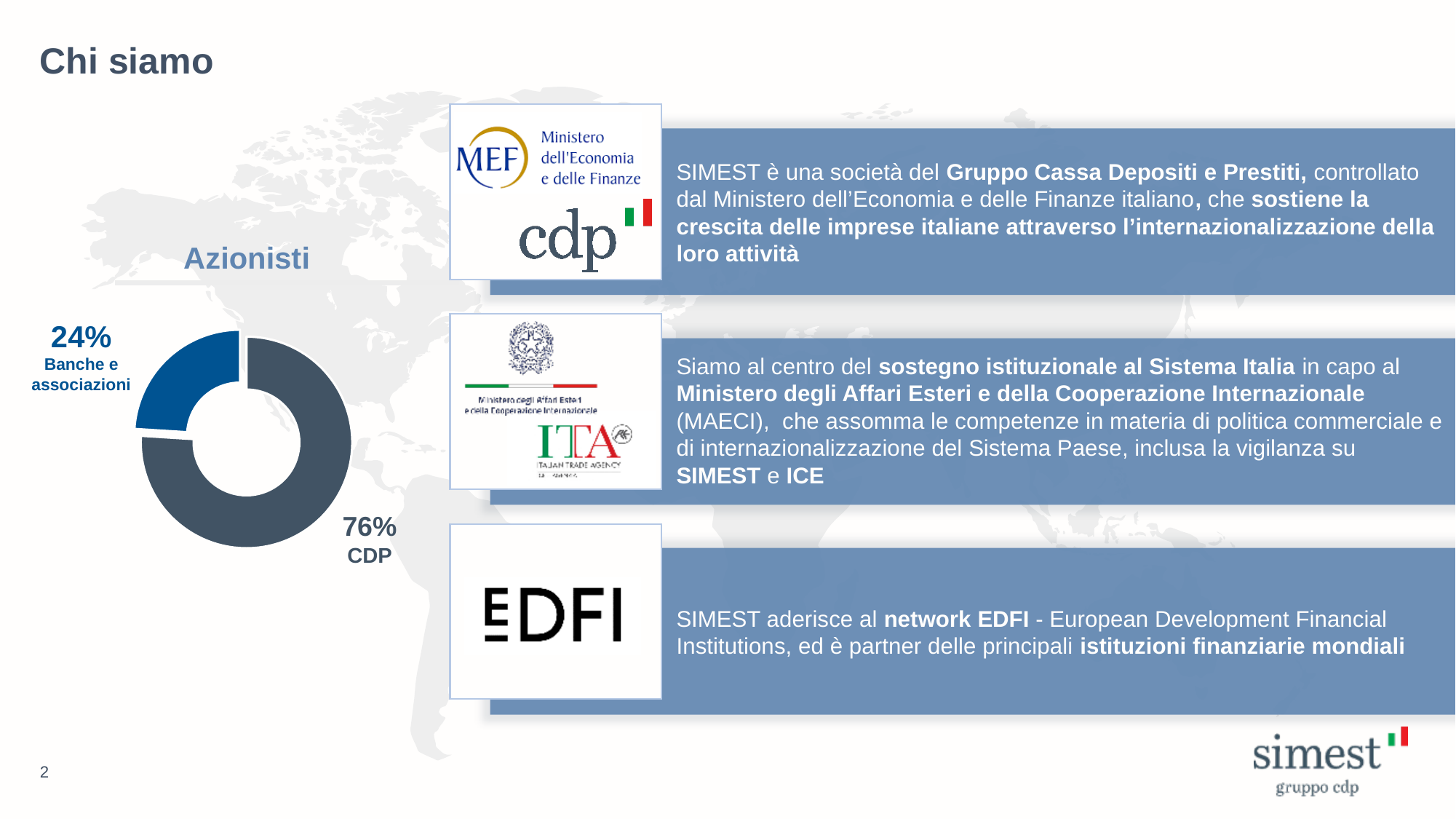
What share of the Azionisti chart does CDP hold? 76% What kind of chart is used to show the Azionisti breakdown? Doughnut chart Which shareholder category has the smallest share in the Azionisti chart? Banche e associazioni Which category is shown in the lighter blue segment of the Azionisti chart? Banche e associazioni Which is larger: the share of CDP or the share of Banche e associazioni? CDP What share of the Azionisti chart do Banche e associazioni hold? 24% Which shareholder category has the largest share in the Azionisti chart? CDP What is the title of the chart on the left of the slide? Azionisti How many categories are shown in the Azionisti chart? 2 What is the total of the two shares shown in the Azionisti chart? 100% What is the difference in percentage points between the CDP share and the Banche e associazioni share? 52